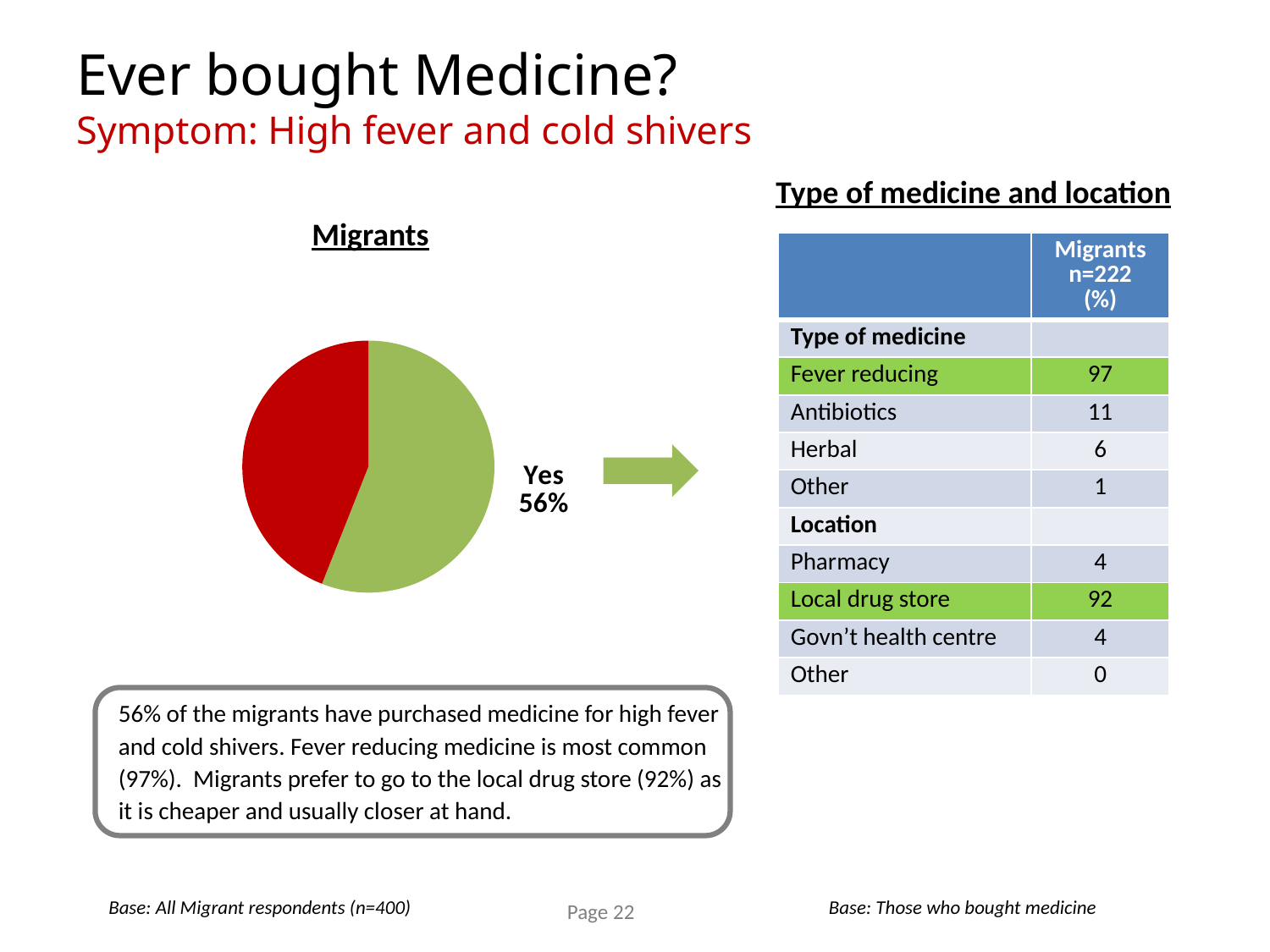
Which slice of the pie chart is larger, the green "Yes" slice or the red slice? the green "Yes" slice What percentage of migrants answered "Yes" in the pie chart? 56% What kind of chart is shown on the slide? pie chart What colour is the "Yes" slice in the pie chart? green What is the title of the pie chart? Migrants Is the "Yes" share in the pie chart greater or less than 50%? greater Which slice of the pie chart is the largest? Yes How many slices does the pie chart have? 2 What share of the pie chart is labelled "Yes"? 56%